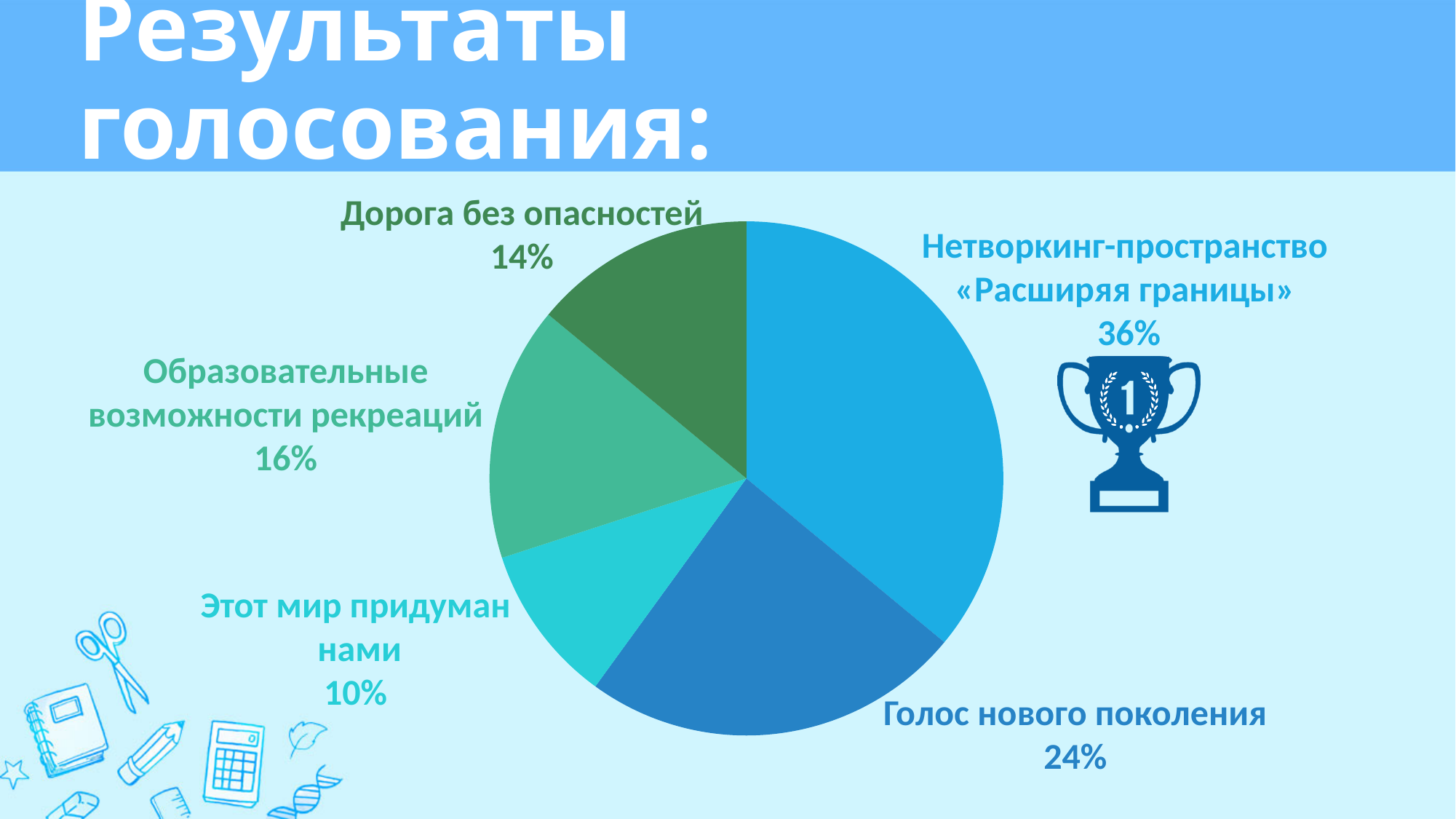
What percentage is shown for «Этот мир придуман нами»? 10% What share of the vote did «Нетворкинг-пространство «Расширяя границы»» receive? 36% Which received a larger share: «Образовательные возможности рекреаций» or «Дорога без опасностей»? Образовательные возможности рекреаций What is the difference in percentage points between «Нетворкинг-пространство «Расширяя границы»» and «Голос нового поколения»? 12 What percentage is shown for «Голос нового поколения»? 24% What type of chart is shown on the slide? Pie chart Which option received the smallest share of the vote? Этот мир придуман нами How many options are shown in the pie chart? 5 What percentage is shown for «Дорога без опасностей»? 14% What is the title of the slide? Результаты голосования: Which option received the largest share of the vote? Нетворкинг-пространство «Расширяя границы» What percentage is shown for «Образовательные возможности рекреаций»? 16%